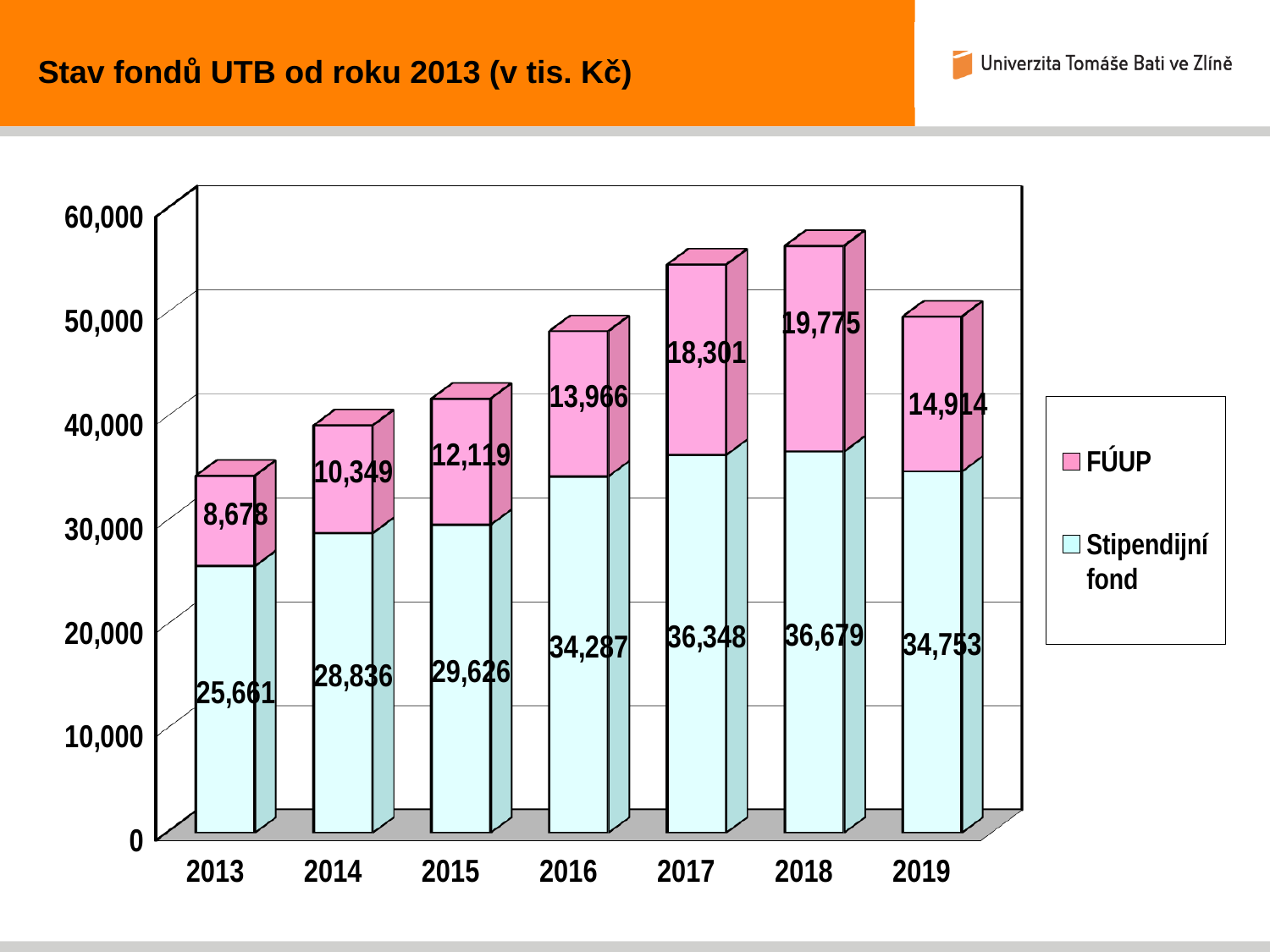
What is the value of Stipendijní fond for 2016? 34,287 What kind of chart is shown on the slide? stacked bar chart How many series does the legend list? 2 What is the value of FÚUP for 2013? 8,678 What is the value of FÚUP for 2018? 19,775 What is the total of the stacked bar for 2018? 56,454 In which year is the Stipendijní fond value lowest? 2013 How many years are shown on the x axis? 7 In which year is the FÚUP value highest? 2018 Is the total stacked value for 2017 greater or less than 50,000? greater Which is larger, the Stipendijní fond value for 2019 or for 2016? 2019 What is the difference between the FÚUP values for 2017 and 2019? 3,387